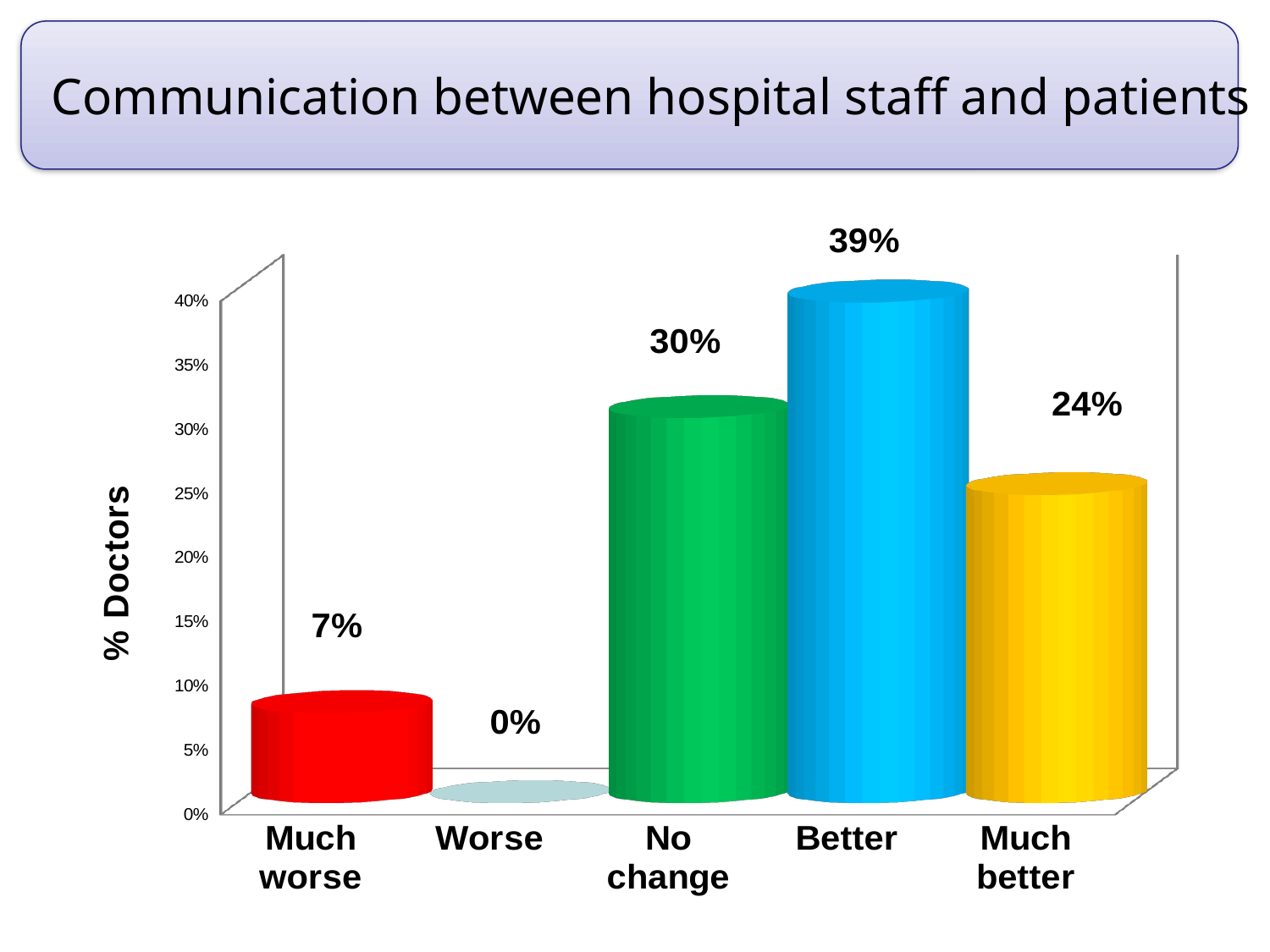
What is the label of the vertical axis? % Doctors Which category has the highest value? Better What is the value for 'Much better'? 24% What is the value for 'Much worse'? 7% What percentage of doctors said communication was 'Better'? 39% How many categories are shown on the x axis? 5 Which is larger, the value for 'No change' or the value for 'Much better'? No change What is the difference between the values for 'Much better' and 'Much worse'? 17% What is the value for 'No change'? 30% Which category has the lowest value? Worse What kind of chart is shown on the slide? Bar chart What is the difference between the values for 'Better' and 'No change'? 9%